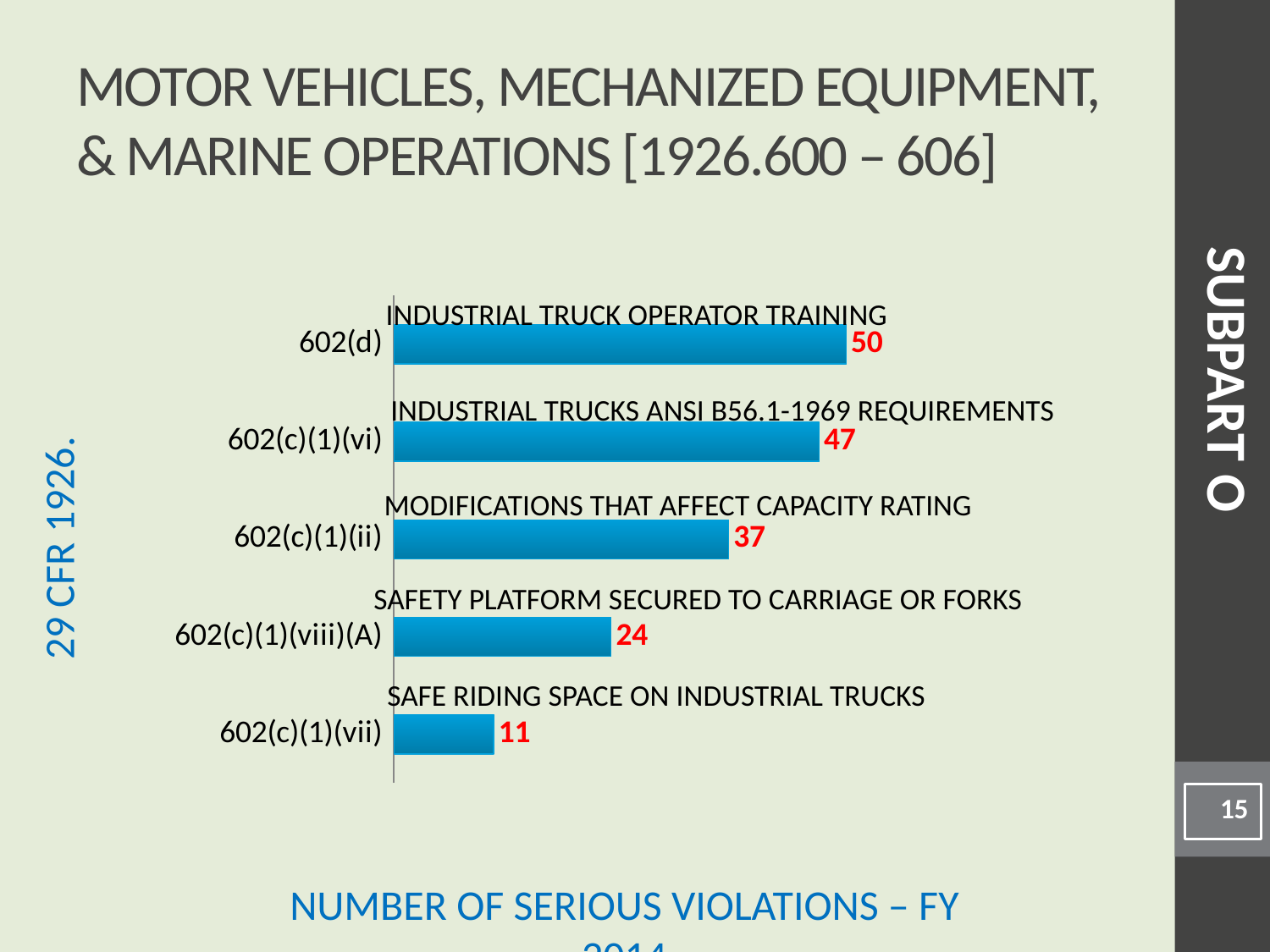
How many categories are shown in the chart? 5 What is the value shown for 602(c)(1)(vii)? 11 What is the value shown for 602(c)(1)(vi)? 47 What is the total of all the values shown in the chart? 169 Which is larger, the value for 602(c)(1)(ii) or the value for 602(c)(1)(viii)(A)? 602(c)(1)(ii) What description is printed above the bar for 602(c)(1)(ii)? MODIFICATIONS THAT AFFECT CAPACITY RATING What kind of chart is shown on the slide? Bar chart What is the number of serious violations for 602(d)? 50 Which category has the highest number of serious violations? 602(d) What is the value shown for 602(c)(1)(viii)(A)? 24 Which category has the lowest number of serious violations? 602(c)(1)(vii) What is the difference between the values for 602(d) and 602(c)(1)(ii)? 13